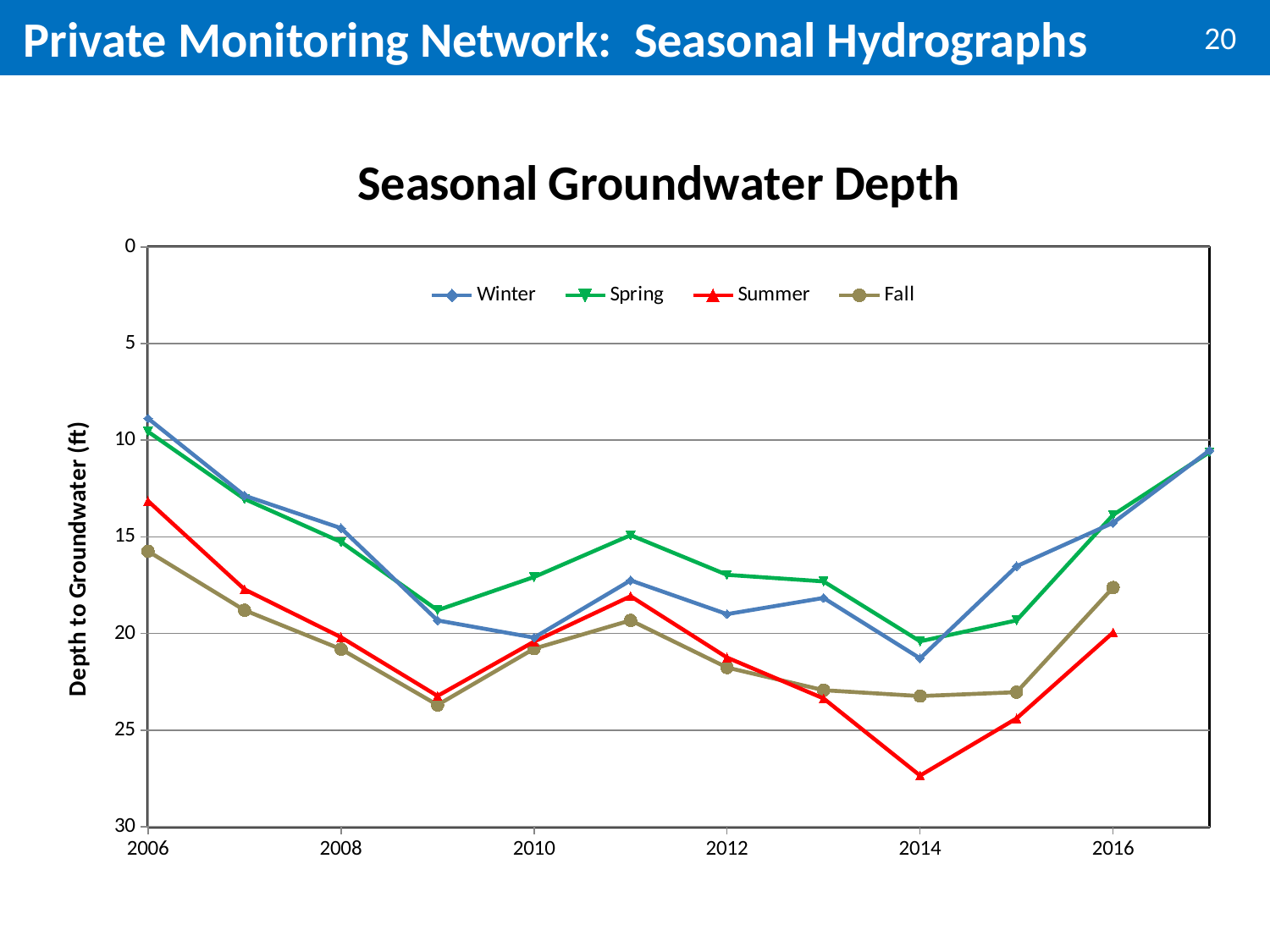
What is the title of the chart? Seasonal Groundwater Depth In which year does the Summer series reach its greatest depth? 2014 Is the Summer depth in 2009 greater or less than 20? greater Is the Fall depth in 2016 greater or less than 20? less Which series shows the greatest depth to groundwater in 2014? Summer Does the Summer depth to groundwater increase or decrease from 2011 to 2014? increase What is the label on the vertical axis? Depth to Groundwater (ft) Is the Winter depth in 2006 greater or less than 10? less What kind of chart is shown on the slide? Line chart In which year is the Winter depth to groundwater smallest? 2006 How many series does the legend list? 4